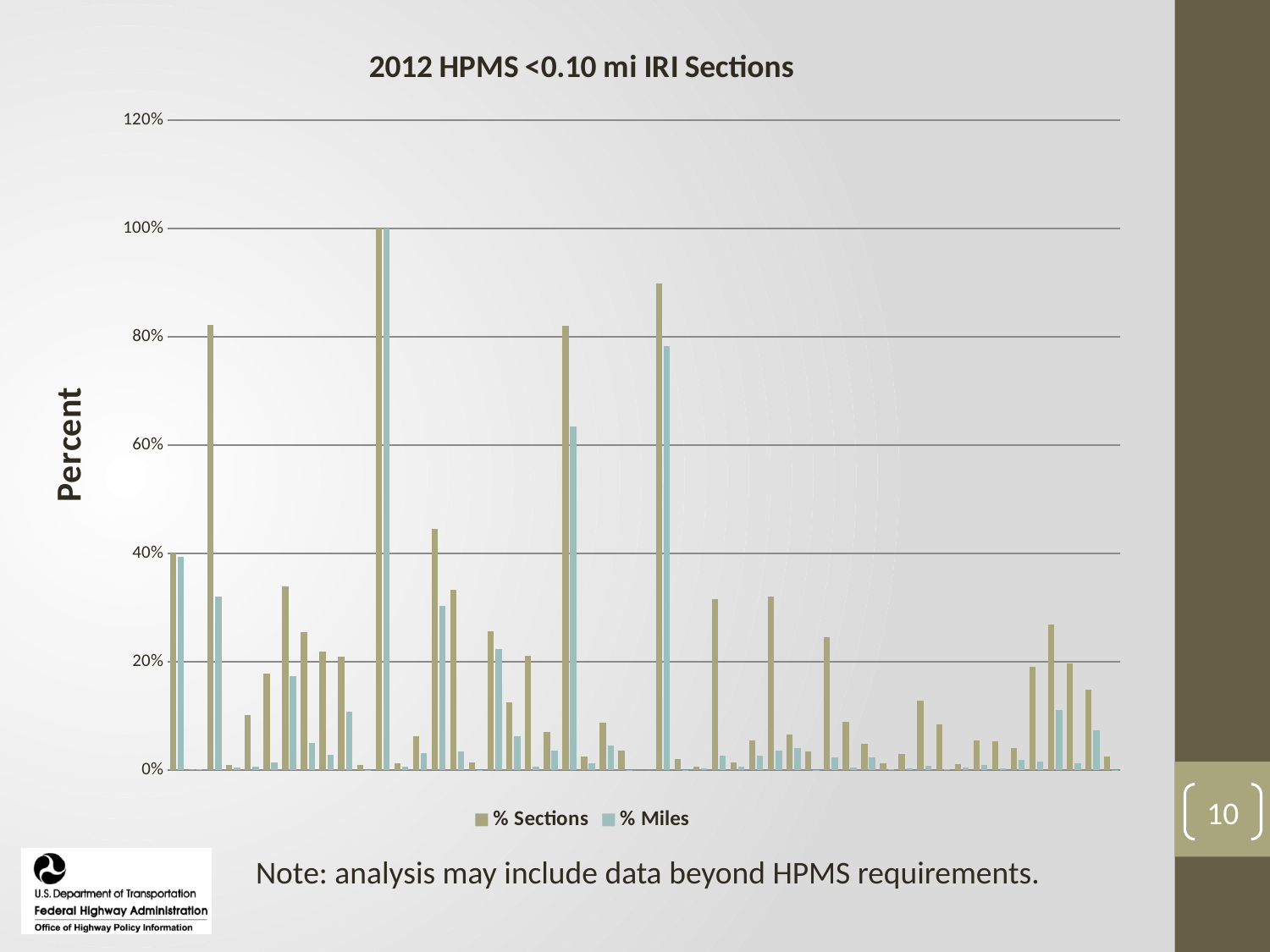
Is the tallest % Sections bar greater or less than 80%? greater What are the two series named in the legend? % Sections and % Miles What kind of chart is shown on the slide? bar chart At the category where % Sections reaches 100%, what is the % Miles value? 100% What is the highest value reached by any bar on the chart? 100% What is the title of the chart? 2012 HPMS <0.10 mi IRI Sections How many series does the chart's legend list? 2 Is the tallest % Miles bar greater or less than 80%? greater